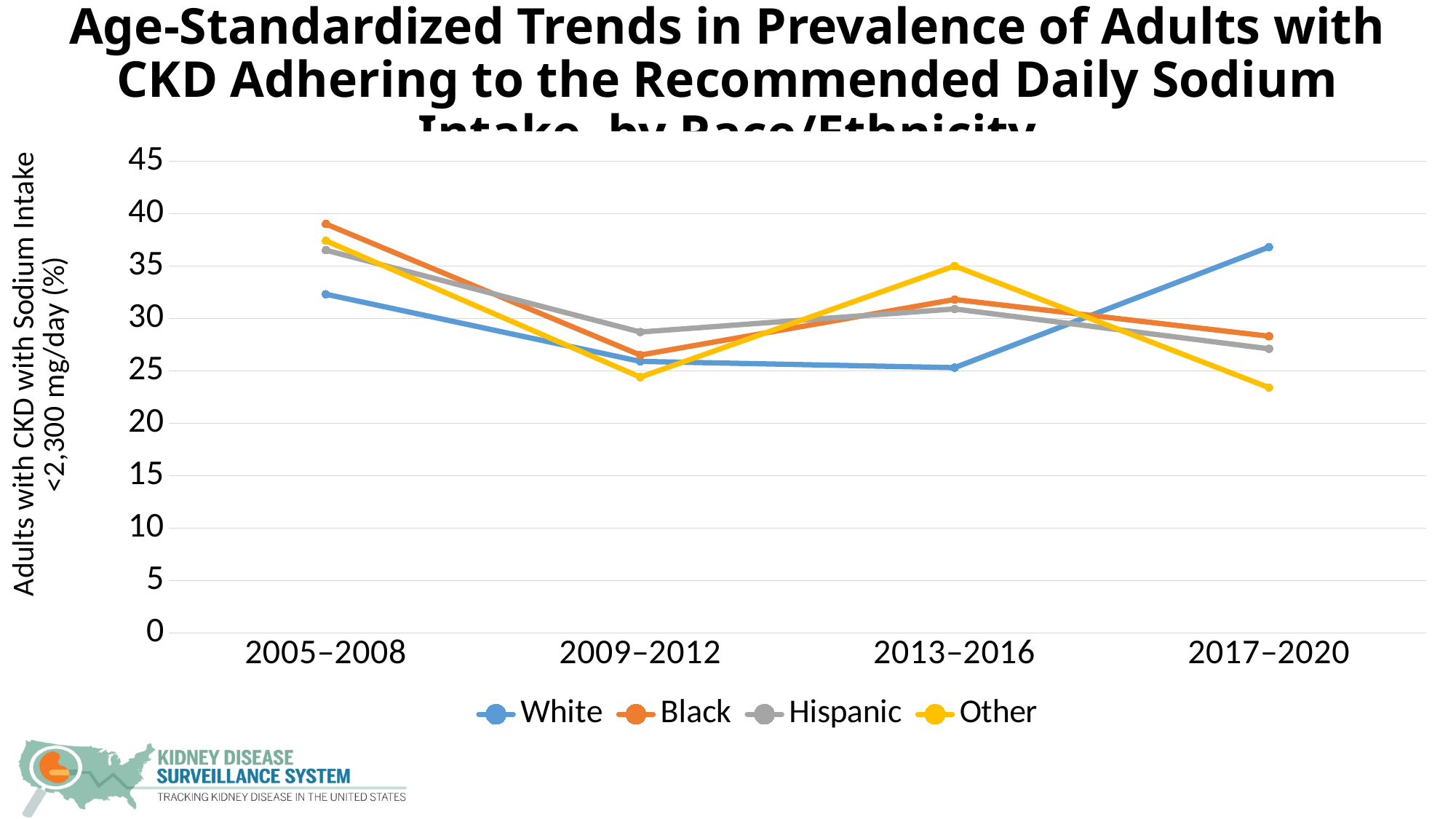
In 2013–2016, which is larger, the value for Other or the value for White? Other How many series does the legend list? 4 Is the value for Other in 2017–2020 greater or less than 25? less Which series has the lowest value in 2013–2016? White Does the White series rise or fall from 2013–2016 to 2017–2020? rise What kind of chart is shown on the slide? line chart Is the value for White in 2017–2020 greater or less than 35? greater Which series has the highest value in 2017–2020? White Which colour is used for the Other series in the legend? yellow How many time periods are shown on the x axis? 4 Which series has the lowest value in 2017–2020? Other Which series has the highest value in 2005–2008? Black